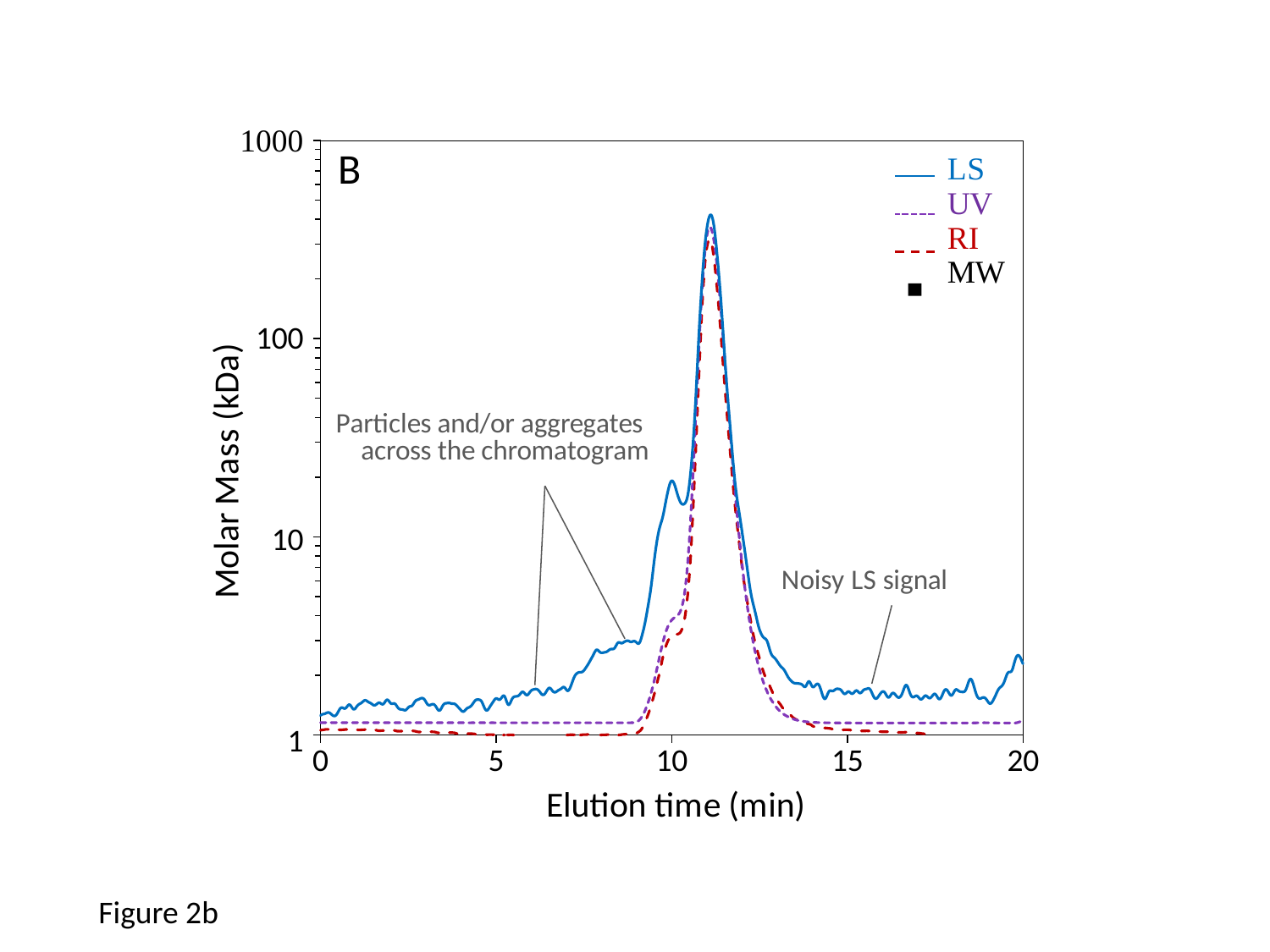
What is the label of the x axis? Elution time (min) Is the elution time at which the main peak occurs greater or less than 10 min? greater Is the peak value of the LS series greater or less than 100? greater What is the label of the y axis? Molar Mass (kDa) What kind of chart is shown on the slide? line chart How many series does the legend list? 4 Is the LS value at an elution time of 20 min greater or less than 10? less How many labelled tick marks are on the x axis? 5 At an elution time of 5 min, which series has the higher value, LS or RI? LS Which series is drawn as a solid blue line? LS Does the LS series rise or fall between elution times of 9 min and 11 min? rise Does the LS series rise or fall between elution times of 12 min and 13 min? fall